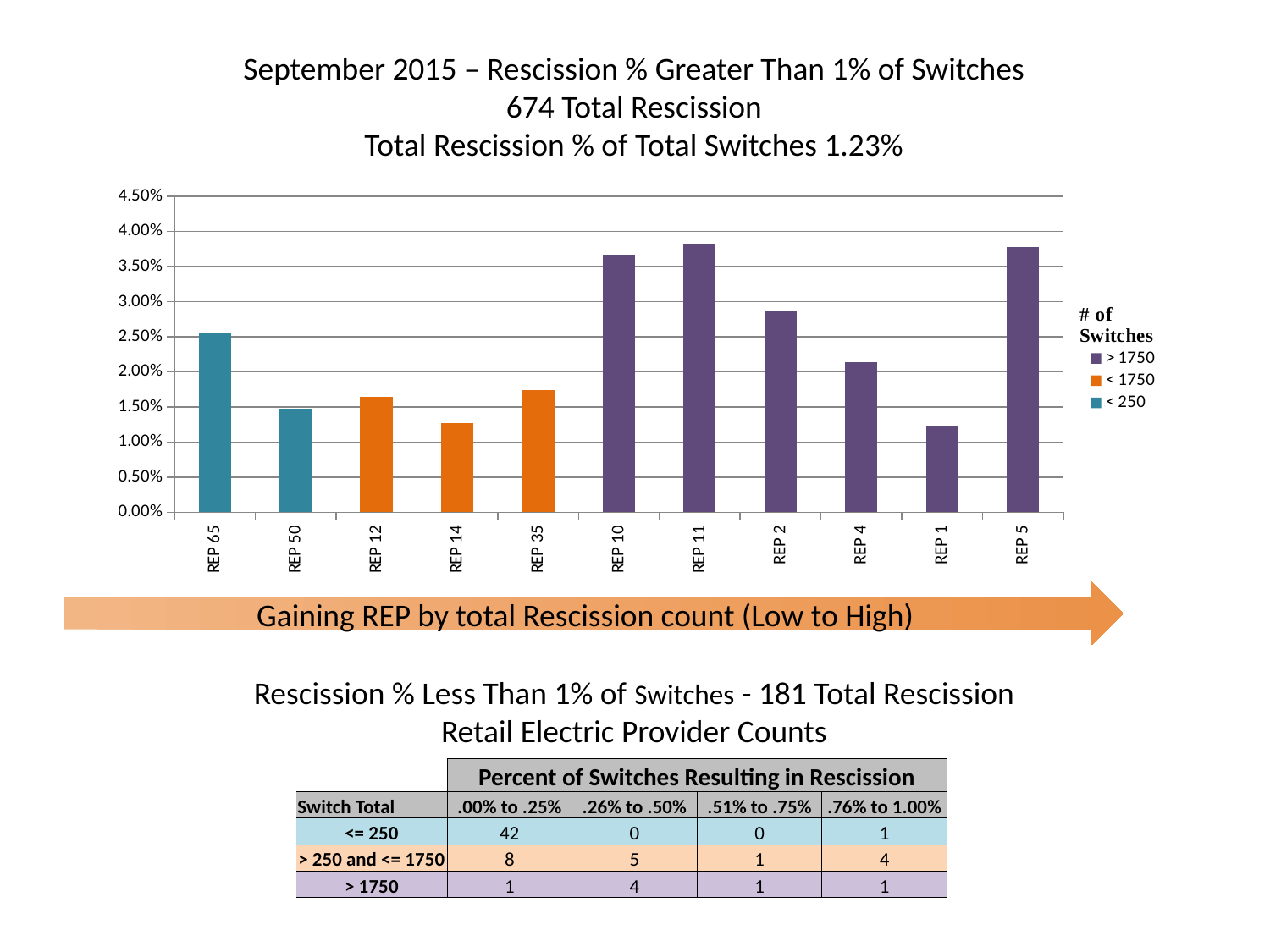
Which has the larger value, REP 2 or REP 4? REP 2 What is the title of the chart's legend? # of Switches What kind of chart is shown on the slide? bar chart Is the value for REP 14 greater or less than 1.50%? less How many REP categories are plotted on the x axis of the chart? 11 How many series does the chart's legend list? 3 Is the value for REP 65 greater or less than 2.00%? greater Is the value for REP 10 greater or less than 3.50%? greater Which has the larger value, REP 10 or REP 65? REP 10